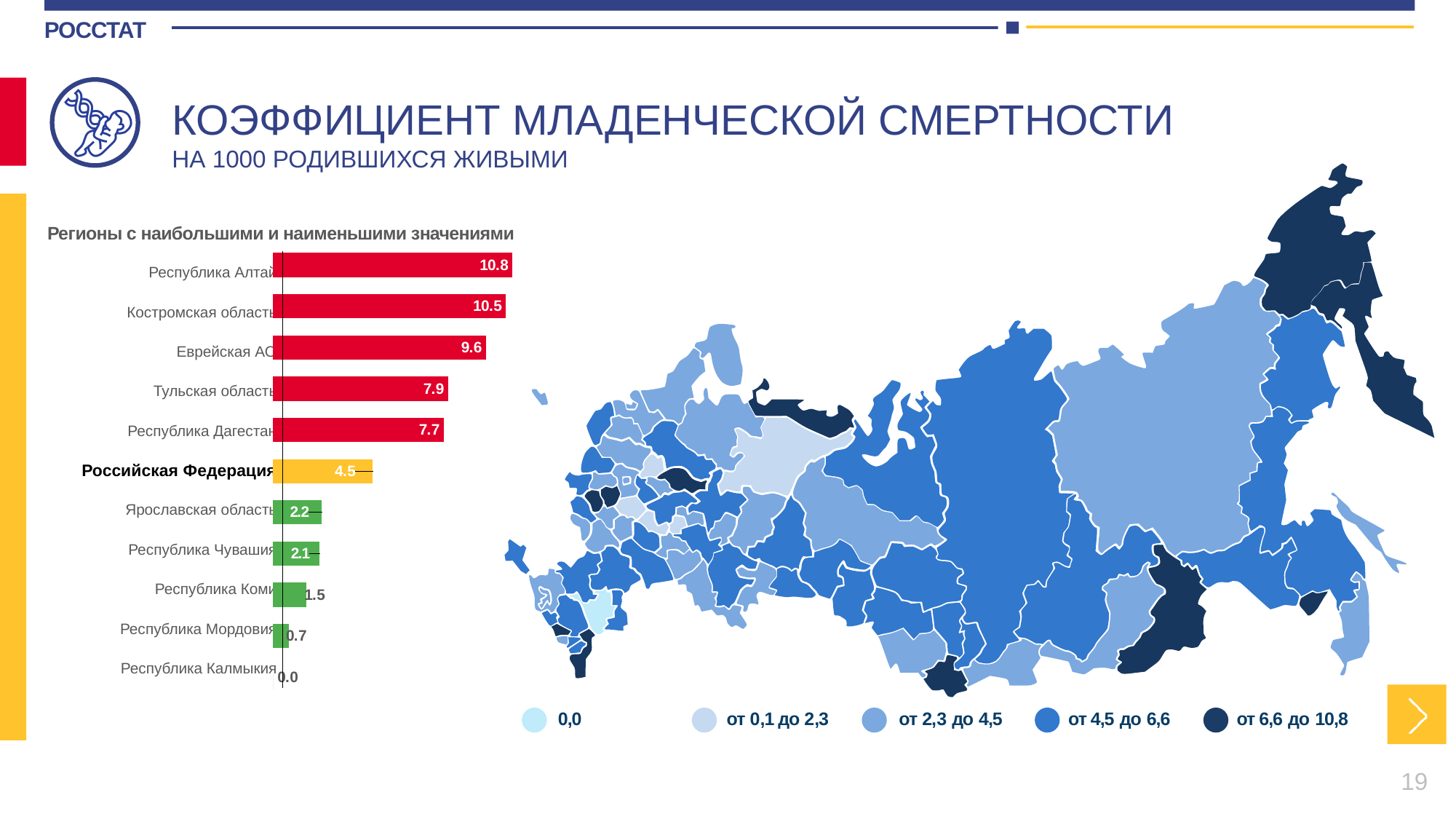
Which region has the lowest value in the bar chart? Республика Калмыкия What is the difference between the values for Тульская область and Российская Федерация? 3.4 What value is shown for Республика Мордовия? 0.7 What is the infant mortality rate shown for Республика Алтай? 10.8 What colour is the bar for Российская Федерация? Yellow What value is shown for Российская Федерация in the bar chart? 4.5 What is the difference between the values for Республика Алтай and Костромская область? 0.3 Which region has the highest value in the bar chart? Республика Алтай What type of chart is used to show the regions with the highest and lowest values? Bar chart How many regions (bars) are shown in the bar chart? 11 Which has a larger value, Республика Коми or Ярославская область? Ярославская область Which has a larger value, Еврейская АО or Республика Дагестан? Еврейская АО